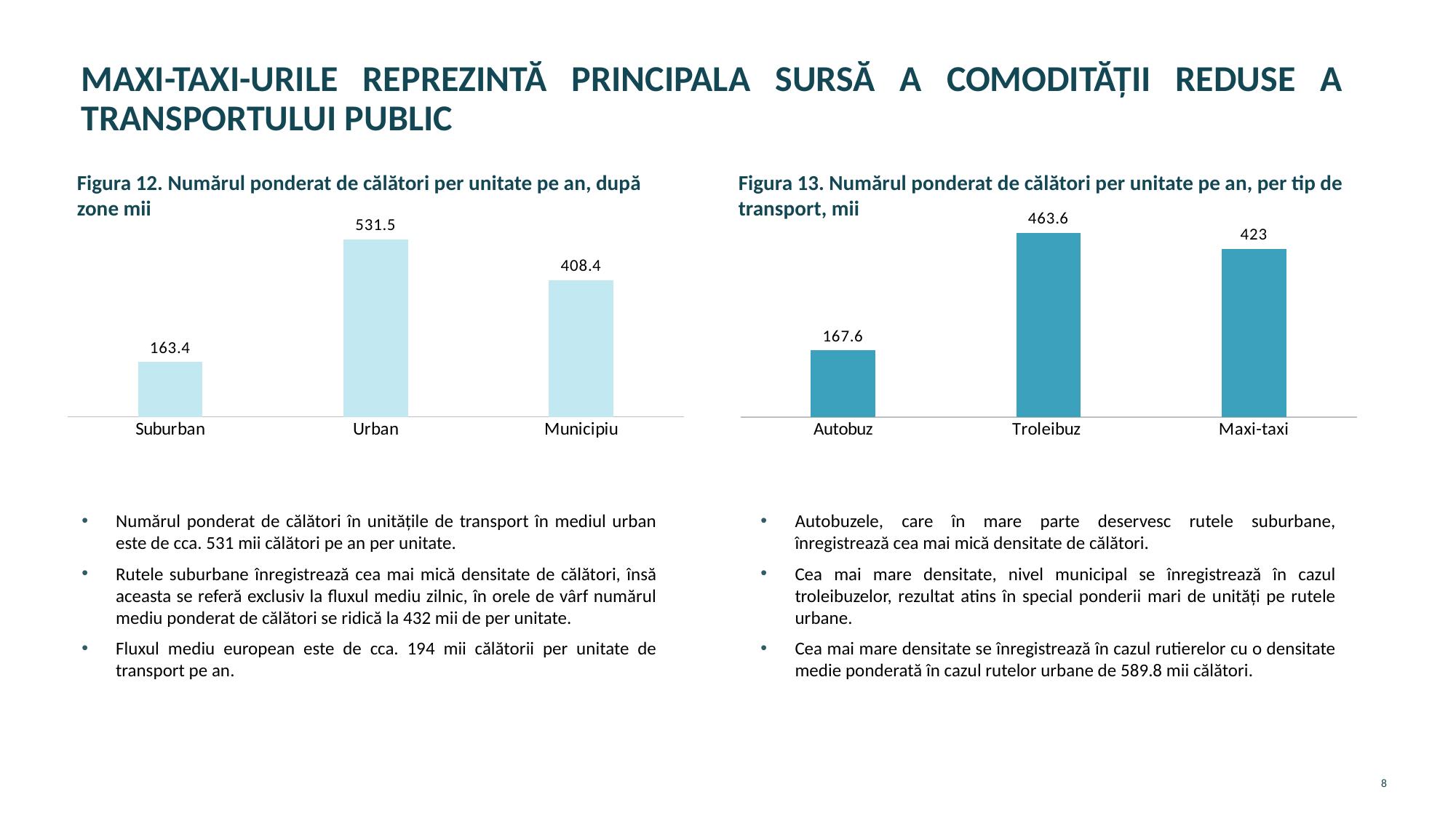
In Figura 12 (left chart), what is the difference between the Urban and Municipiu values? 123.1 In Figura 12 (left chart), what is the value for Suburban? 163.4 In Figura 13 (right chart), what is the value for Troleibuz? 463.6 In Figura 12 (left chart), how many categories are shown? 3 In Figura 12 (left chart), which category has the highest value? Urban In Figura 12 (left chart), what is the value for Urban? 531.5 In Figura 13 (right chart), which is larger, Troleibuz or Maxi-taxi? Troleibuz In Figura 13 (right chart), which category has the lowest value? Autobuz What type of chart is Figura 13 (right chart)? Bar chart In Figura 13 (right chart), what is the value for Maxi-taxi? 423 In Figura 13 (right chart), what is the difference between the Troleibuz and Autobuz values? 296 Do the values in Figura 12 (left chart) rise or fall from Urban to Municipiu? Fall